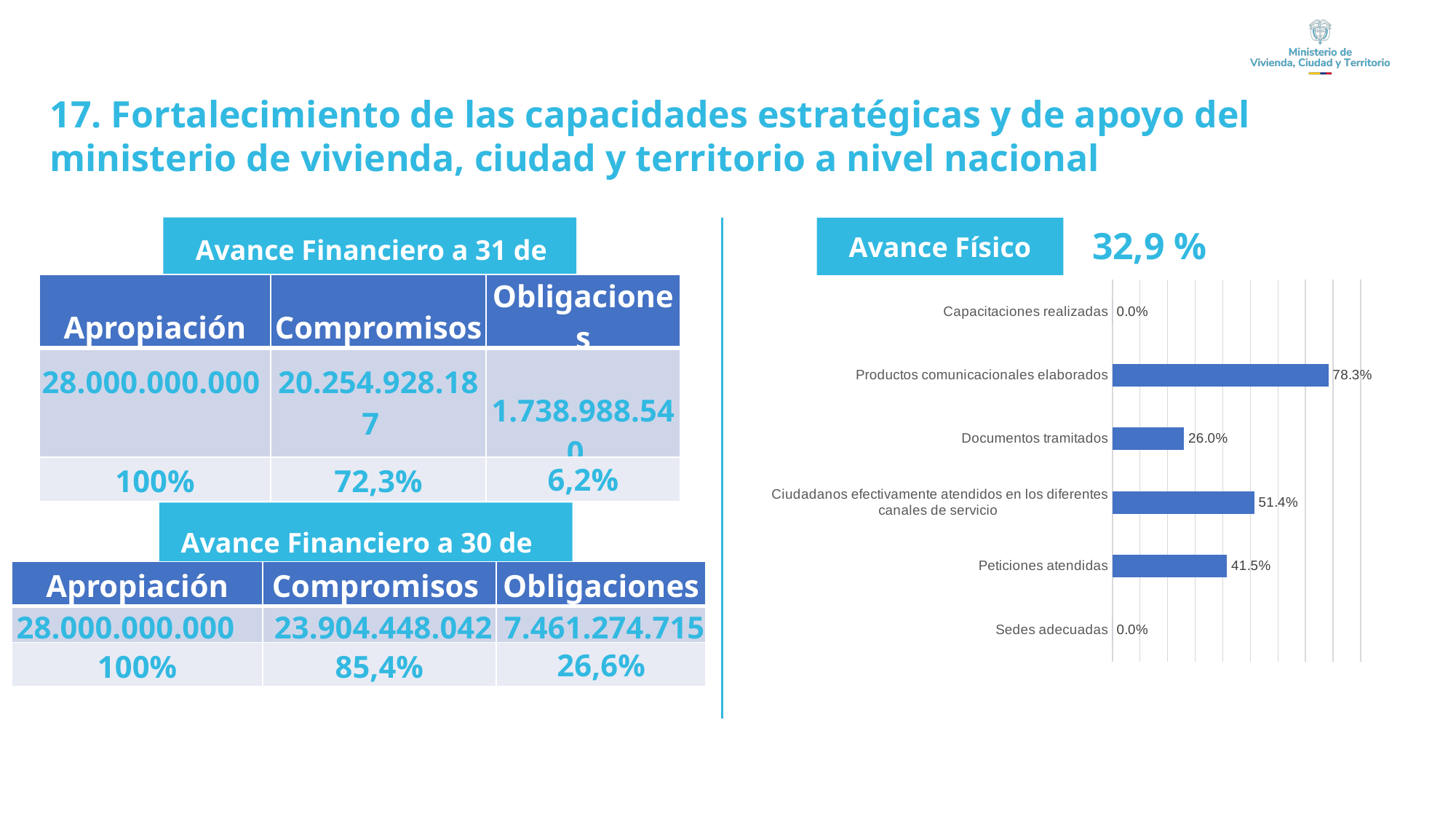
What is the difference between the values for Ciudadanos efectivamente atendidos en los diferentes canales de servicio and Peticiones atendidas in the bar chart? 9.9% What kind of chart is shown on the right side of the slide? Bar chart What is the value for Documentos tramitados in the bar chart? 26.0% Which category has the highest value in the bar chart? Productos comunicacionales elaborados What is the value for Peticiones atendidas in the bar chart? 41.5% How many categories are shown in the bar chart? 6 How many categories in the bar chart have a value of 0.0%? 2 What is the difference between the values for Productos comunicacionales elaborados and Documentos tramitados in the bar chart? 52.3% What is the value for Productos comunicacionales elaborados in the bar chart? 78.3% Which is larger in the bar chart: Peticiones atendidas or Documentos tramitados? Peticiones atendidas What is the value for Sedes adecuadas in the bar chart? 0.0% What is the value for Ciudadanos efectivamente atendidos en los diferentes canales de servicio in the bar chart? 51.4%